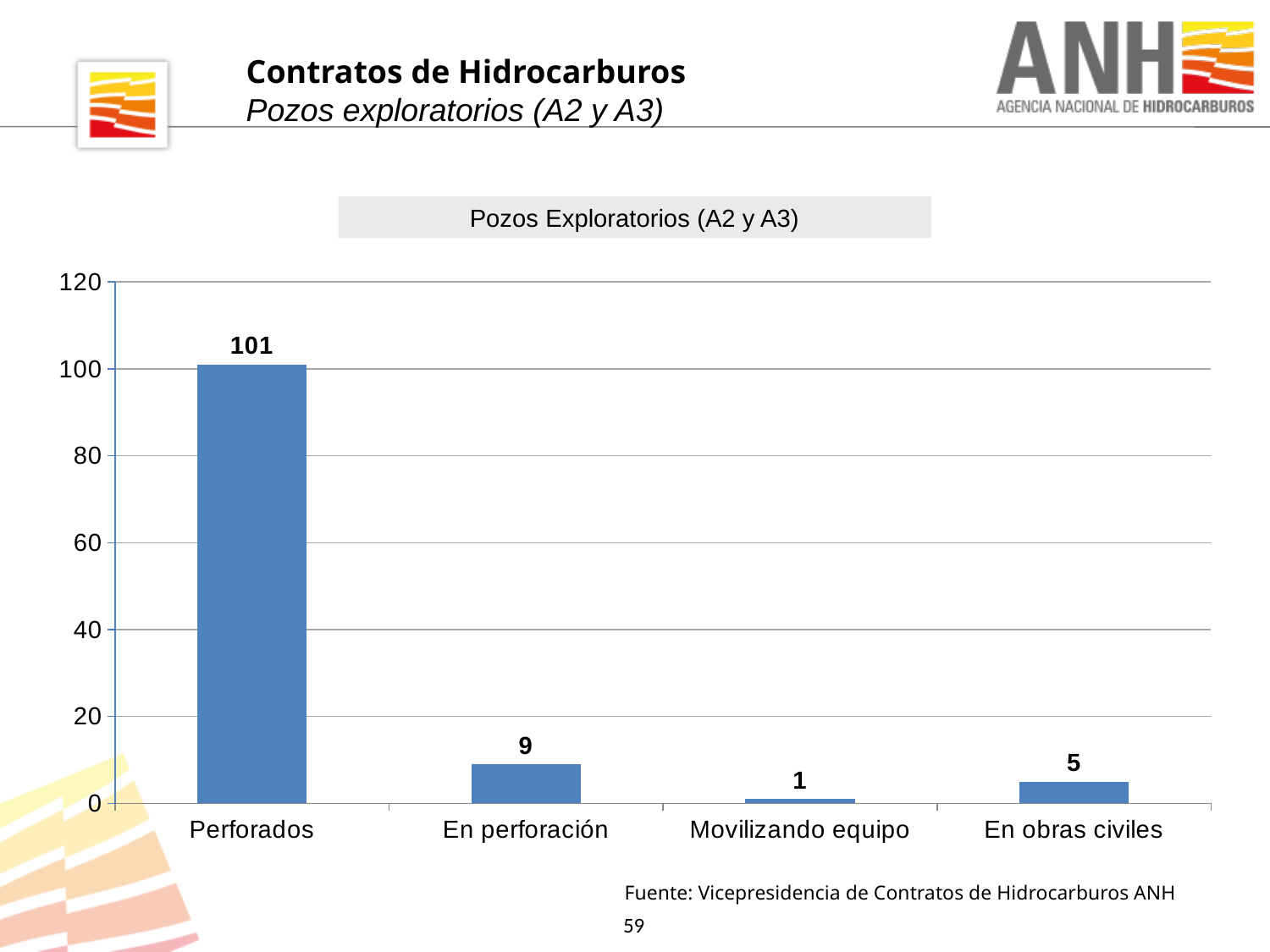
Which category has the lowest value? Movilizando equipo What is the value for Movilizando equipo? 1 Is the value for Perforados greater or less than 100? greater What is the value for En perforación? 9 What kind of chart is shown on the slide? bar chart What is the difference between the values for Perforados and En perforación? 92 What is the difference between the values for En perforación and En obras civiles? 4 What is the value for Perforados? 101 Which is larger, the value for En obras civiles or the value for Movilizando equipo? En obras civiles How many categories are shown on the x axis? 4 What is the value for En obras civiles? 5 Which category has the highest value? Perforados